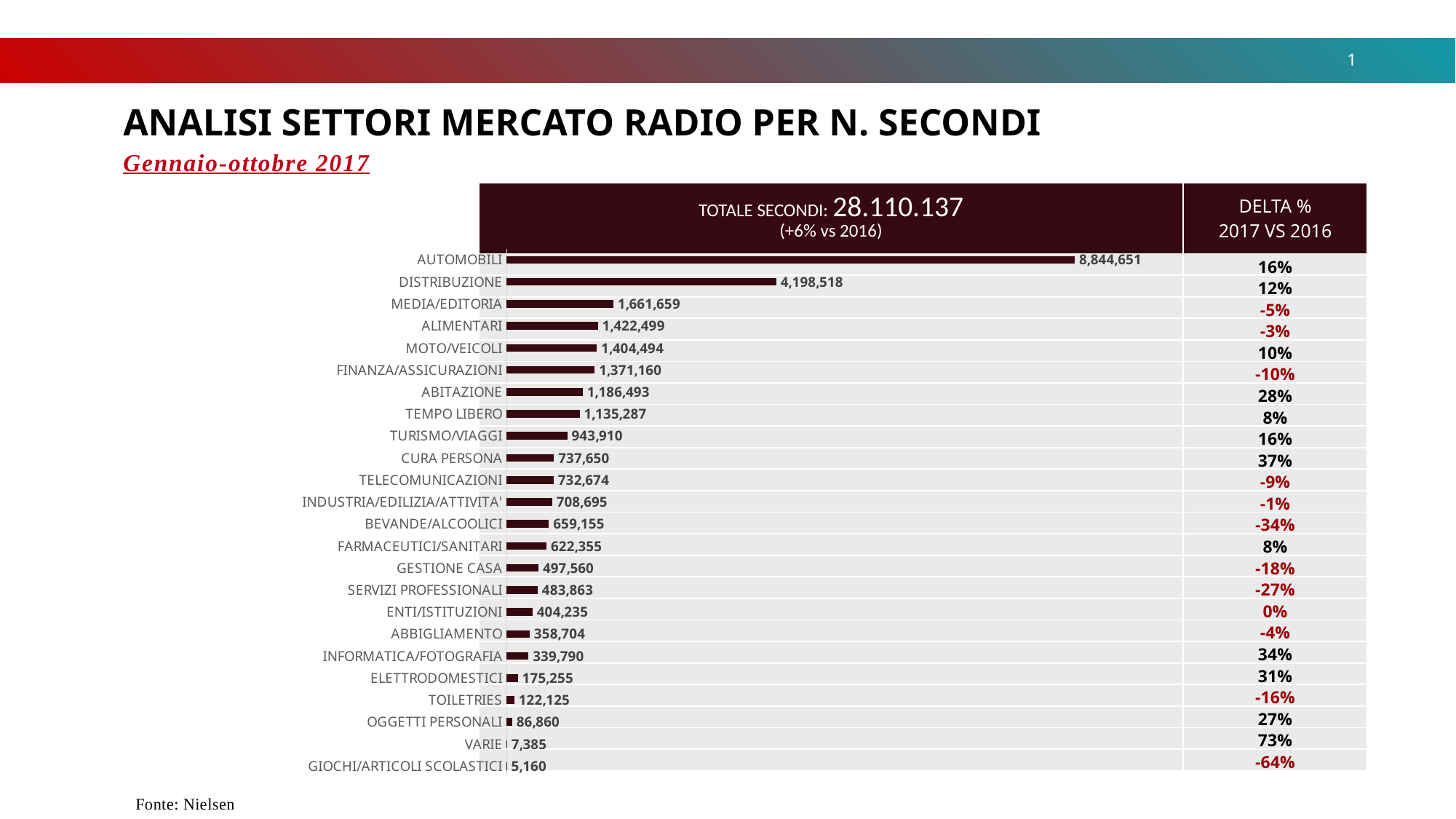
Which category has the highest value? AUTOMOBILI What is the value for AUTOMOBILI? 8,844,651 What is the value for GESTIONE CASA? 497,560 What is the value for TURISMO/VIAGGI? 943,910 What type of chart is shown on the slide? bar chart Which is larger, the value for MEDIA/EDITORIA or the value for ABITAZIONE? MEDIA/EDITORIA What total number of seconds is stated in the chart header? 28.110.137 What is the difference between the values for AUTOMOBILI and DISTRIBUZIONE? 4,646,133 What is the difference between the values for ALIMENTARI and MOTO/VEICOLI? 18,005 Which category has the lowest value? GIOCHI/ARTICOLI SCOLASTICI How many categories are shown in the chart? 24 What is the value for OGGETTI PERSONALI? 86,860